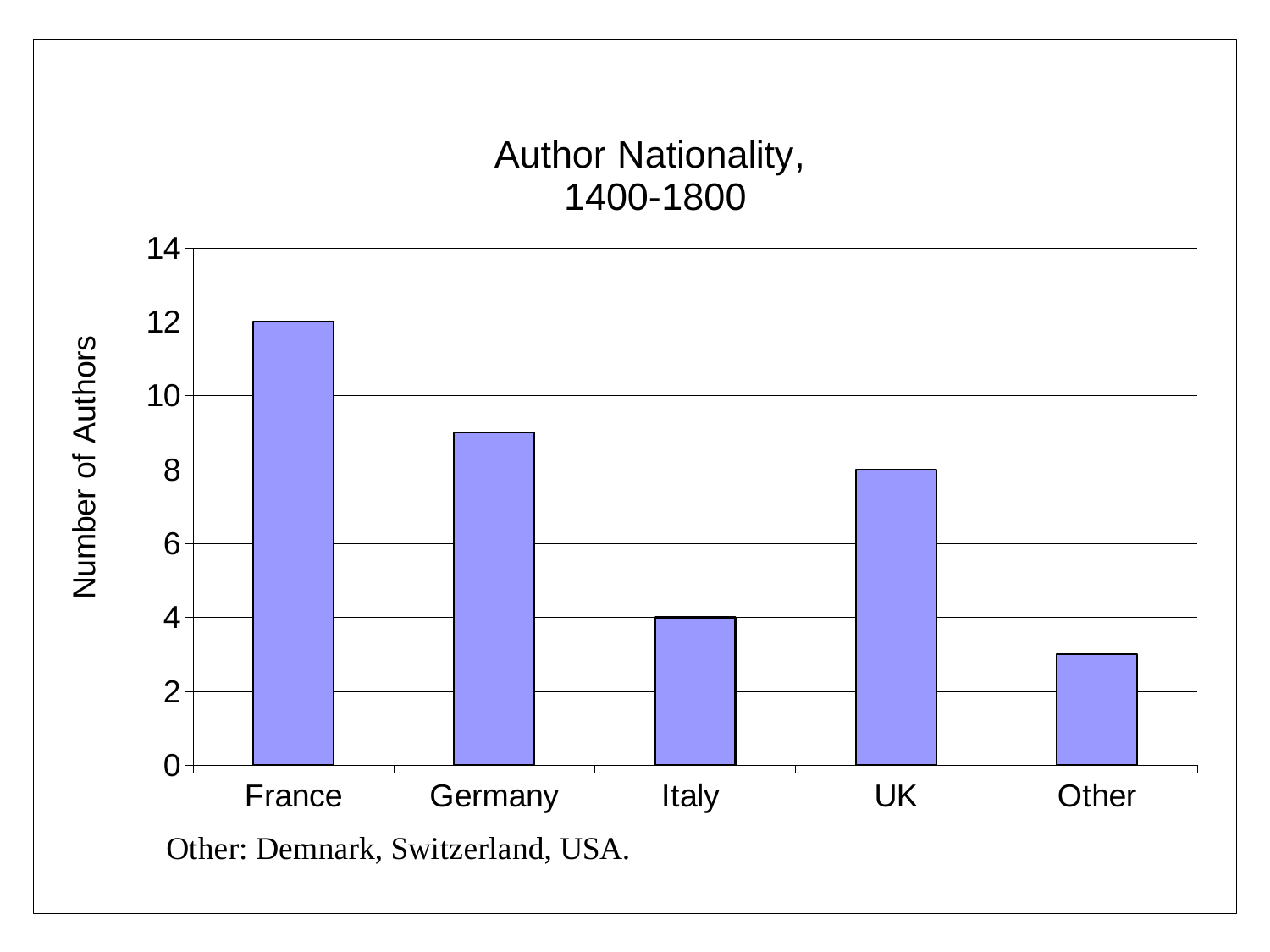
What is the title of the chart? Author Nationality, 1400-1800 Which category has the lowest number of authors? Other What is the number of authors for Italy? 4 Which has more authors, Germany or Italy? Germany What is the number of authors for the UK? 8 How many nationality categories are shown on the x axis? 5 Is the value for Germany greater or less than 8? greater Which nationality has the highest number of authors? France What type of chart is shown on the slide? bar chart What is the number of authors for France? 12 Is the value for Other greater or less than 4? less What is the difference in number of authors between France and the UK? 4